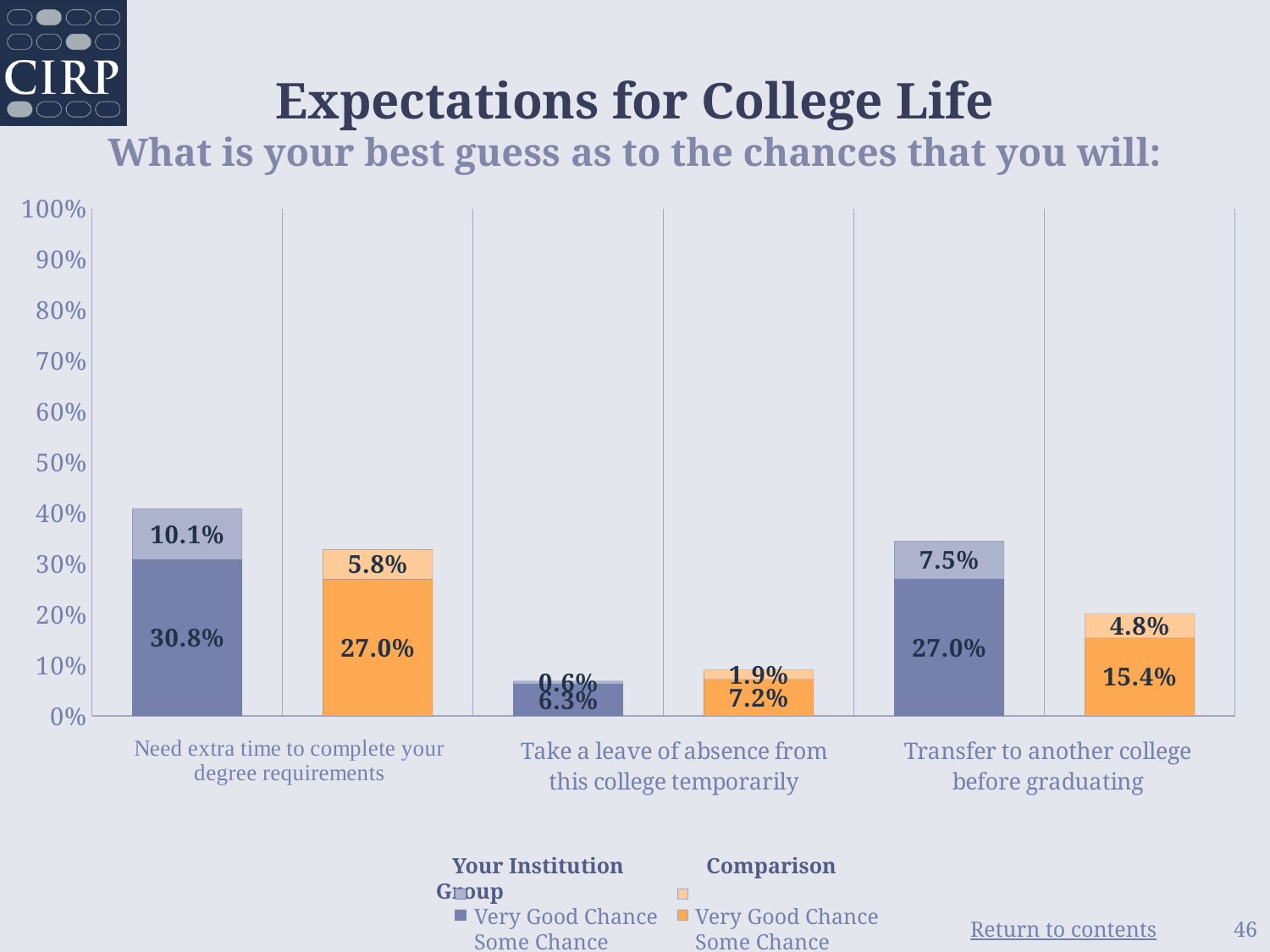
What is the title of the chart? Expectations for College Life What kind of chart is shown on the slide? stacked bar chart What is the Your Institution 'Very Good Chance' value for 'Need extra time to complete your degree requirements'? 10.1% What is the Comparison Group 'Some Chance' value for 'Transfer to another college before graduating'? 15.4% What is the difference between the Your Institution and Comparison Group 'Very Good Chance' values for 'Transfer to another college before graduating'? 2.7% Which category has the lowest Your Institution 'Very Good Chance' value? Take a leave of absence from this college temporarily How many categories are shown on the x axis? 3 What is the Comparison Group 'Very Good Chance' value for 'Take a leave of absence from this college temporarily'? 1.9% Which category has the highest Comparison Group 'Very Good Chance' value? Need extra time to complete your degree requirements Is the Your Institution 'Very Good Chance' value for 'Need extra time to complete your degree requirements' larger or smaller than the Comparison Group value? larger What is the Your Institution 'Some Chance' value for 'Transfer to another college before graduating'? 27.0% What is the total of the Your Institution stacked bar for 'Need extra time to complete your degree requirements'? 40.9%